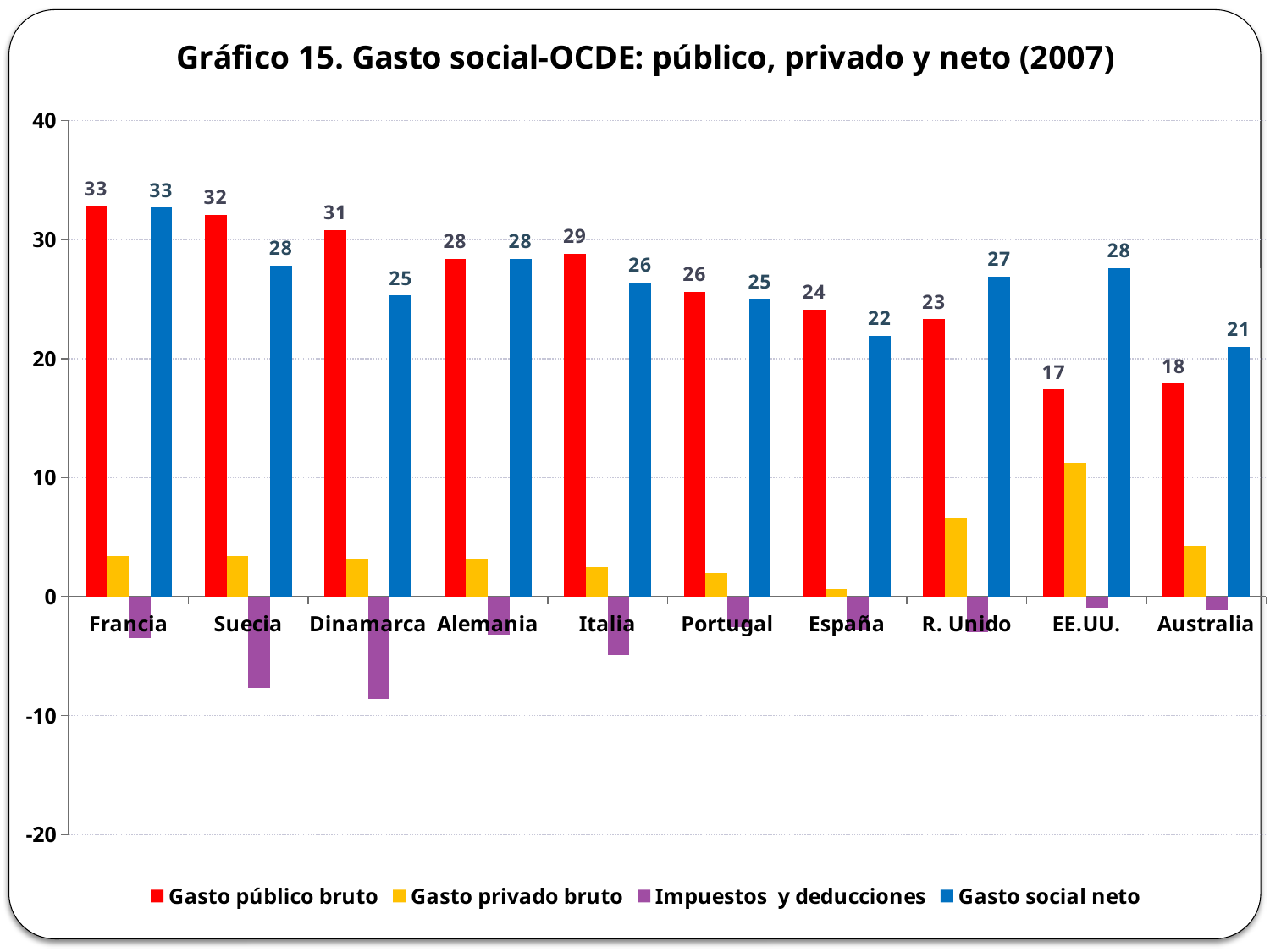
How many countries are shown on the x axis? 10 What is the difference between Gasto público bruto and Gasto social neto for Dinamarca? 6 What is the value of Gasto público bruto for Francia? 33 What kind of chart is shown on the slide? Bar chart What is the value of Gasto social neto for Australia? 21 Is the value of Gasto privado bruto for EE.UU. greater or less than 10? greater Which country has the lowest Gasto público bruto? EE.UU. Which series is shown in purple? Impuestos y deducciones Which is larger for R. Unido: Gasto público bruto or Gasto social neto? Gasto social neto Which country has the highest Gasto social neto? Francia How many series does the legend list? 4 What is the value of Gasto social neto for EE.UU.? 28